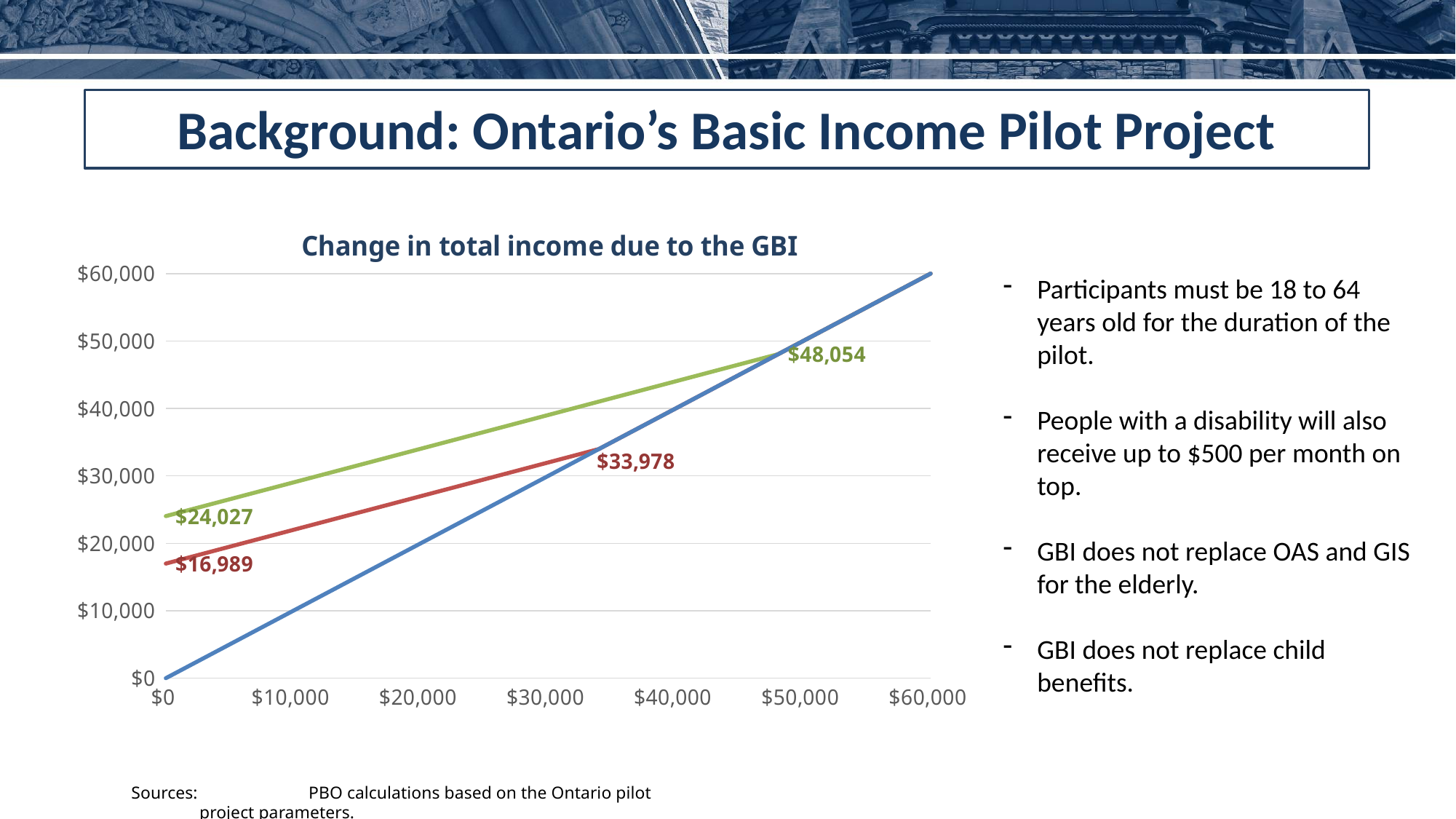
At $0 on the x axis, which line has the higher value, the green line or the red line? Green line How much higher is the green line's starting value than the red line's starting value? $7,038 What is the labelled starting value of the red line at $0 on the x axis? $16,989 What is the difference between the end value of the green line ($48,054) and its starting value ($24,027)? $24,027 What type of chart is shown on the slide? Line chart What is the title of the chart? Change in total income due to the GBI How many lines are plotted on the chart? 3 Do the lines rise or fall as the x-axis value increases? Rise What is the labelled value at the end of the green line? $48,054 What is the labelled starting value of the green line at $0 on the x axis? $24,027 What is the difference between the end value of the red line ($33,978) and its starting value ($16,989)? $16,989 What is the labelled value at the end of the red line? $33,978